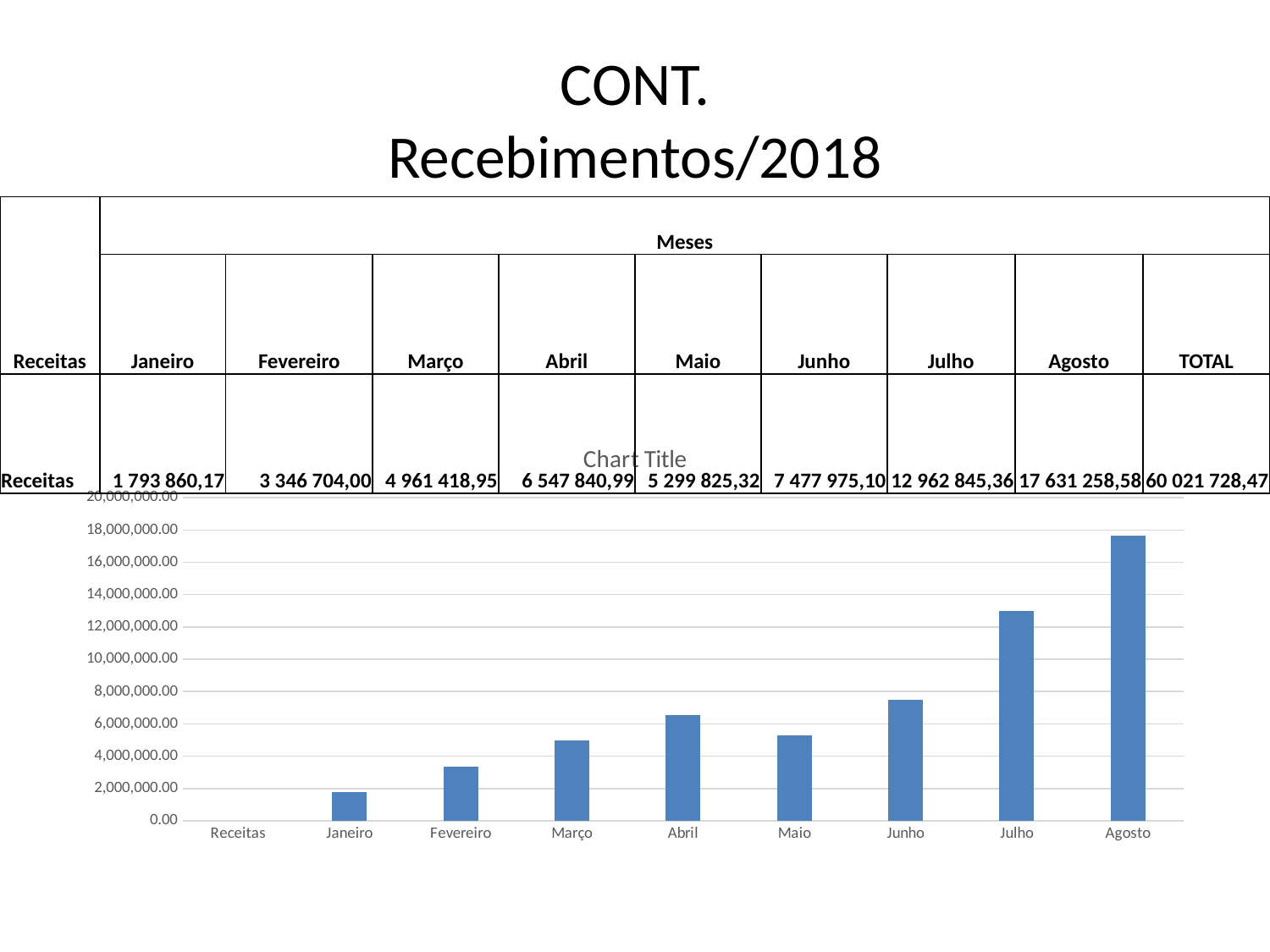
How many months have a bar plotted in the chart? 8 Using the values in the table, what is the difference between Agosto and Julho? 4 668 413,22 According to the table above the chart, what is the value of Receitas for Agosto? 17 631 258,58 Is the bar for Fevereiro greater or less than 4,000,000.00? less What kind of chart is shown on the slide? bar chart What title is displayed on the chart? Chart Title According to the table above the chart, what is the value of Receitas for Janeiro? 1 793 860,17 Which month has the tallest bar in the chart? Agosto Is the bar for Junho greater or less than 6,000,000.00? greater Which month has the shortest bar in the chart? Janeiro Is the bar for Julho greater or less than 12,000,000.00? greater Which bar is taller, Abril or Maio? Abril